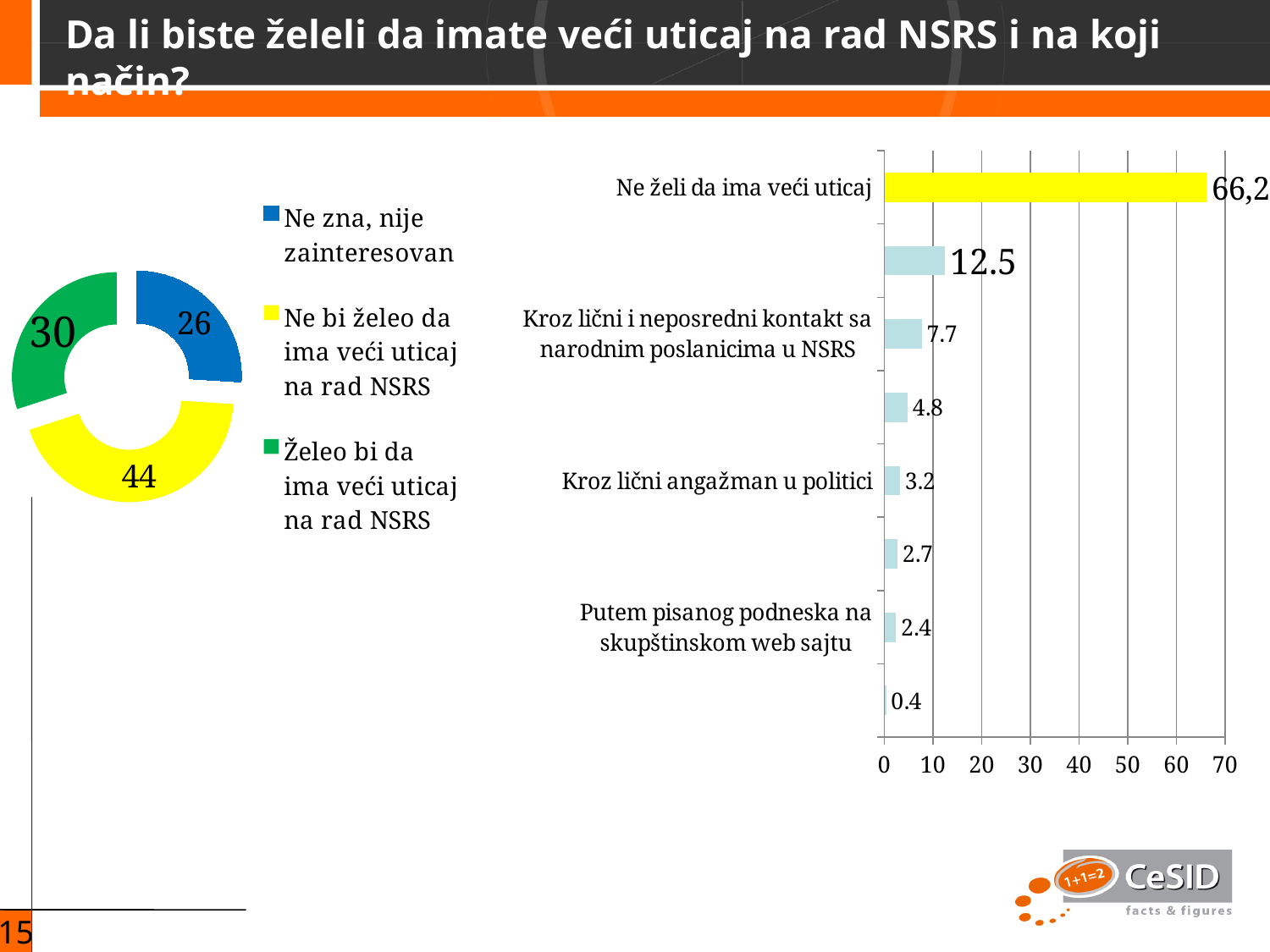
In the doughnut chart on the left, what is the difference between the values for "Ne bi želeo da ima veći uticaj na rad NSRS" and "Želeo bi da ima veći uticaj na rad NSRS"? 14 In the doughnut chart on the left, what is the value for "Ne bi želeo da ima veći uticaj na rad NSRS"? 44 In the doughnut chart on the left, what colour is the segment for "Želeo bi da ima veći uticaj na rad NSRS"? Green In the bar chart on the right, which is larger: the value for "Kroz lični angažman u politici" or the value for "Putem pisanog podneska na skupštinskom web sajtu"? Kroz lični angažman u politici In the doughnut chart on the left, how many entries does the legend list? 3 In the doughnut chart on the left, which category has the smallest value? Ne zna, nije zainteresovan In the bar chart on the right, what is the value for "Kroz lični i neposredni kontakt sa narodnim poslanicima u NSRS"? 7.7 What kind of chart is shown on the right side of the slide? Bar chart In the bar chart on the right, what is the value for "Putem pisanog podneska na skupštinskom web sajtu"? 2.4 In the doughnut chart on the left, what is the value for "Ne zna, nije zainteresovan"? 26 In the doughnut chart on the left, which category has the largest value? Ne bi želeo da ima veći uticaj na rad NSRS In the bar chart on the right, what is the value for "Ne želi da ima veći uticaj"? 66,2